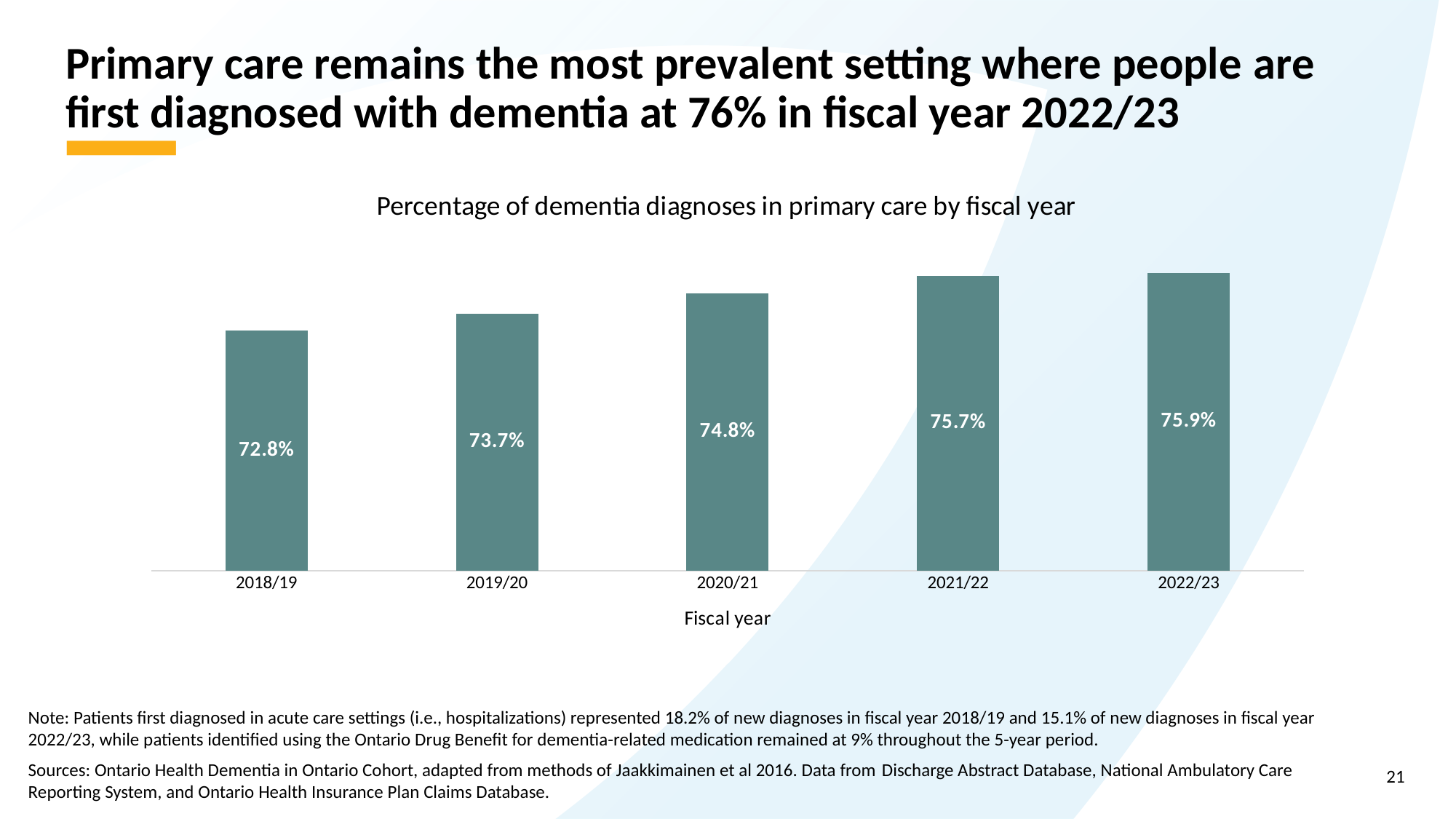
What is the value shown for fiscal year 2020/21? 74.8% What is the difference between the values for 2022/23 and 2018/19? 3.1 percentage points What is the difference between the values for 2020/21 and 2019/20? 1.1 percentage points What percentage of dementia diagnoses were in primary care in fiscal year 2018/19? 72.8% What is the value shown for fiscal year 2022/23? 75.9% What is the title of the chart? Percentage of dementia diagnoses in primary care by fiscal year Which fiscal year has the lowest percentage of dementia diagnoses in primary care? 2018/19 Which fiscal year has the highest percentage of dementia diagnoses in primary care? 2022/23 Do the values rise or fall from 2018/19 to 2022/23? Rise How many fiscal years are shown on the chart? 5 What kind of chart is shown on the slide? Bar chart Which fiscal year has a larger value, 2019/20 or 2021/22? 2021/22